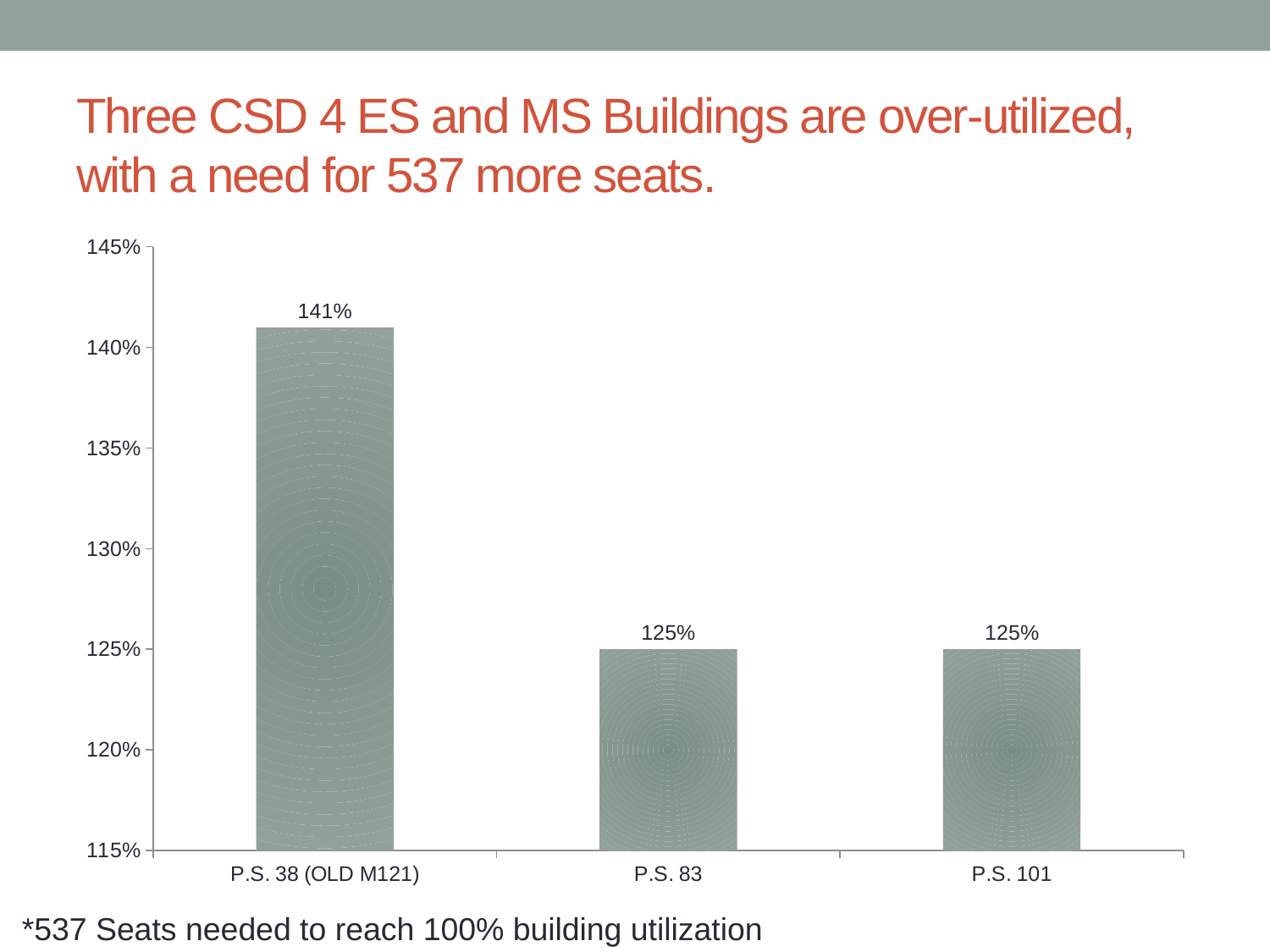
Is the value for P.S. 83 greater or less than 130%? less What is the difference between the utilization of P.S. 38 (OLD M121) and P.S. 83? 16% Which is larger, the value for P.S. 38 (OLD M121) or the value for P.S. 101? P.S. 38 (OLD M121) What is the utilization value for P.S. 83? 125% Do the values rise or fall from P.S. 38 (OLD M121) to P.S. 83? fall How many buildings are shown in the chart? 3 Is the value for P.S. 38 (OLD M121) greater or less than 135%? greater What is the utilization value for P.S. 101? 125% Which building has the highest utilization? P.S. 38 (OLD M121) What is the lowest value shown on the vertical axis? 115% What kind of chart is shown on the slide? bar chart What is the utilization value for P.S. 38 (OLD M121)? 141%